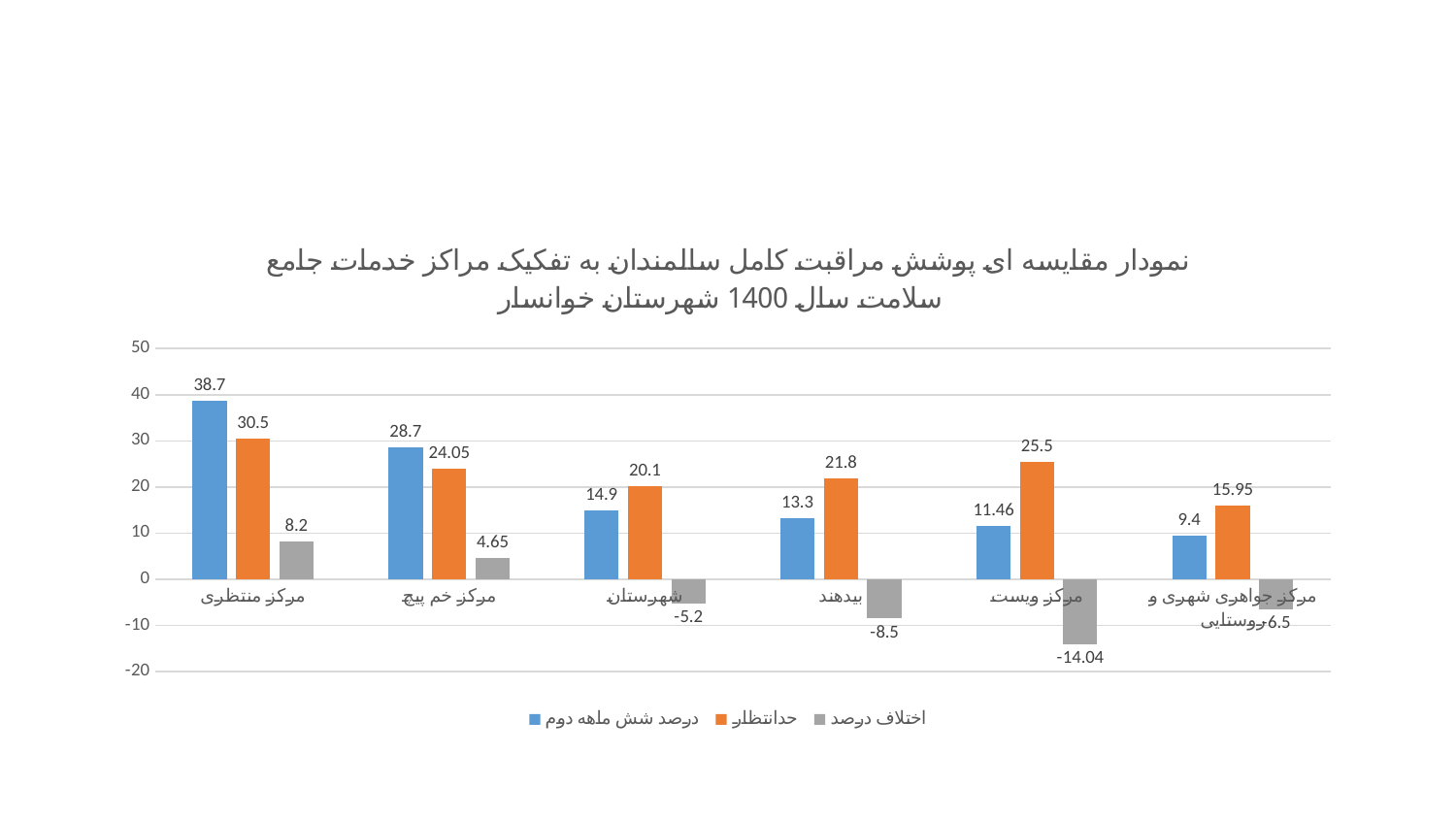
Which category has the lowest value for اختلاف درصد? مرکز ویست What is the value of حدانتظار for مرکز خم پیچ? 24.05 Which category has the highest value for درصد شش ماهه دوم? مرکز منتظری What type of chart is shown on the slide? bar chart What is the value of اختلاف درصد for بیدهند? -8.5 How many series does the legend list? 3 What is the difference between درصد شش ماهه دوم and حدانتظار for شهرستان? 5.2 What is the value of حدانتظار for مرکز ویست? 25.5 Which is larger for بیدهند: درصد شش ماهه دوم or حدانتظار? حدانتظار Does the value of درصد شش ماهه دوم fall or rise from مرکز منتظری to مرکز جواهری شهری و روستایی along the x axis? fall How many categories are shown on the x axis? 6 What is the value of درصد شش ماهه دوم for مرکز منتظری? 38.7